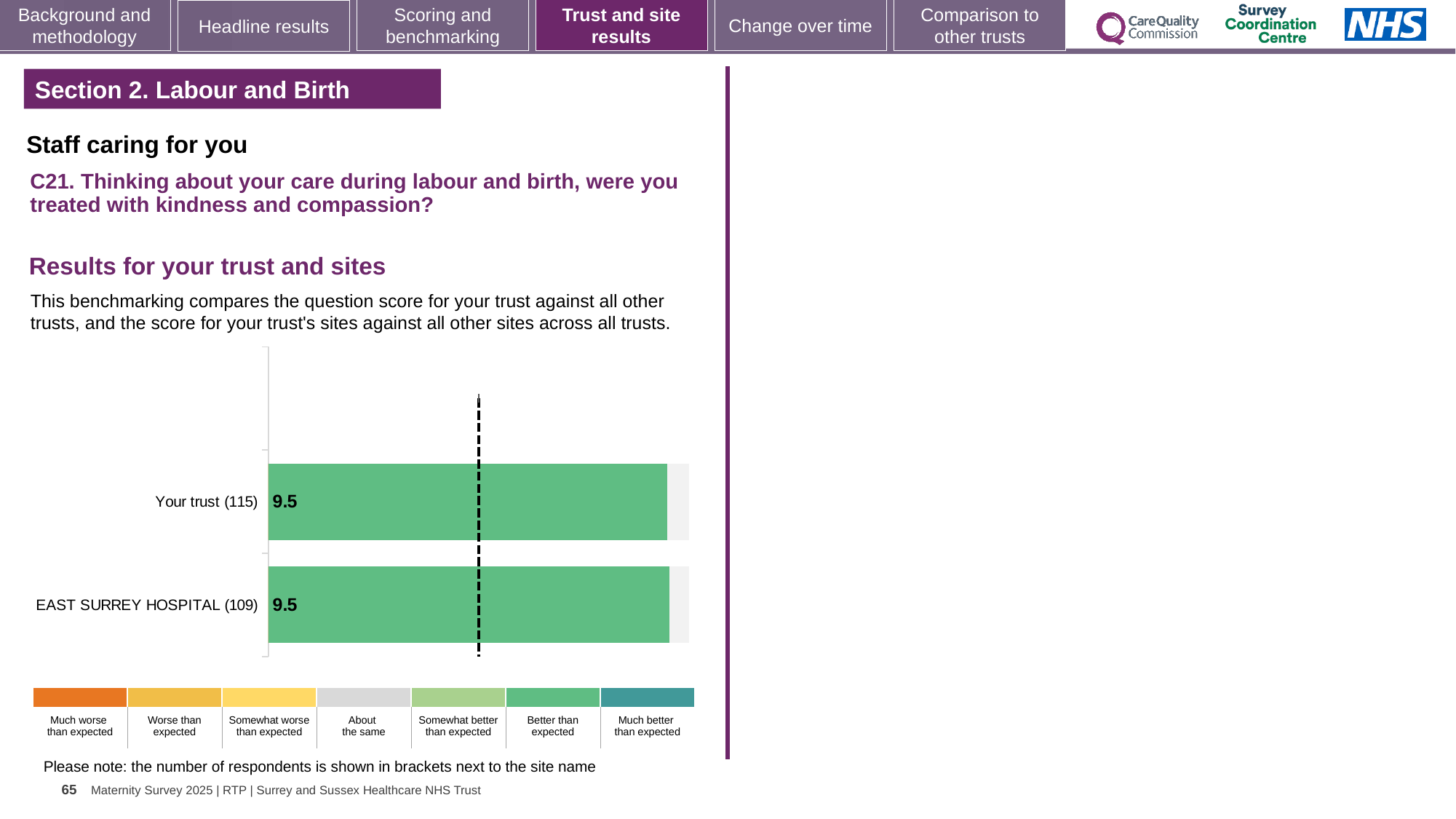
What is the score for Your trust in the chart? 9.5 How many bars are plotted in the chart? 2 What is the score for EAST SURREY HOSPITAL in the chart? 9.5 Is the score for Your trust higher than, lower than, or equal to the score for EAST SURREY HOSPITAL? equal What is the difference between the score for Your trust and the score for EAST SURREY HOSPITAL? 0 How many categories does the colour key below the chart list? 7 How many respondents are shown in brackets next to EAST SURREY HOSPITAL? 109 How many respondents are shown in brackets next to Your trust? 115 Which colour-key category does the green colour of the two bars correspond to? Better than expected What kind of chart is shown on the slide? bar chart